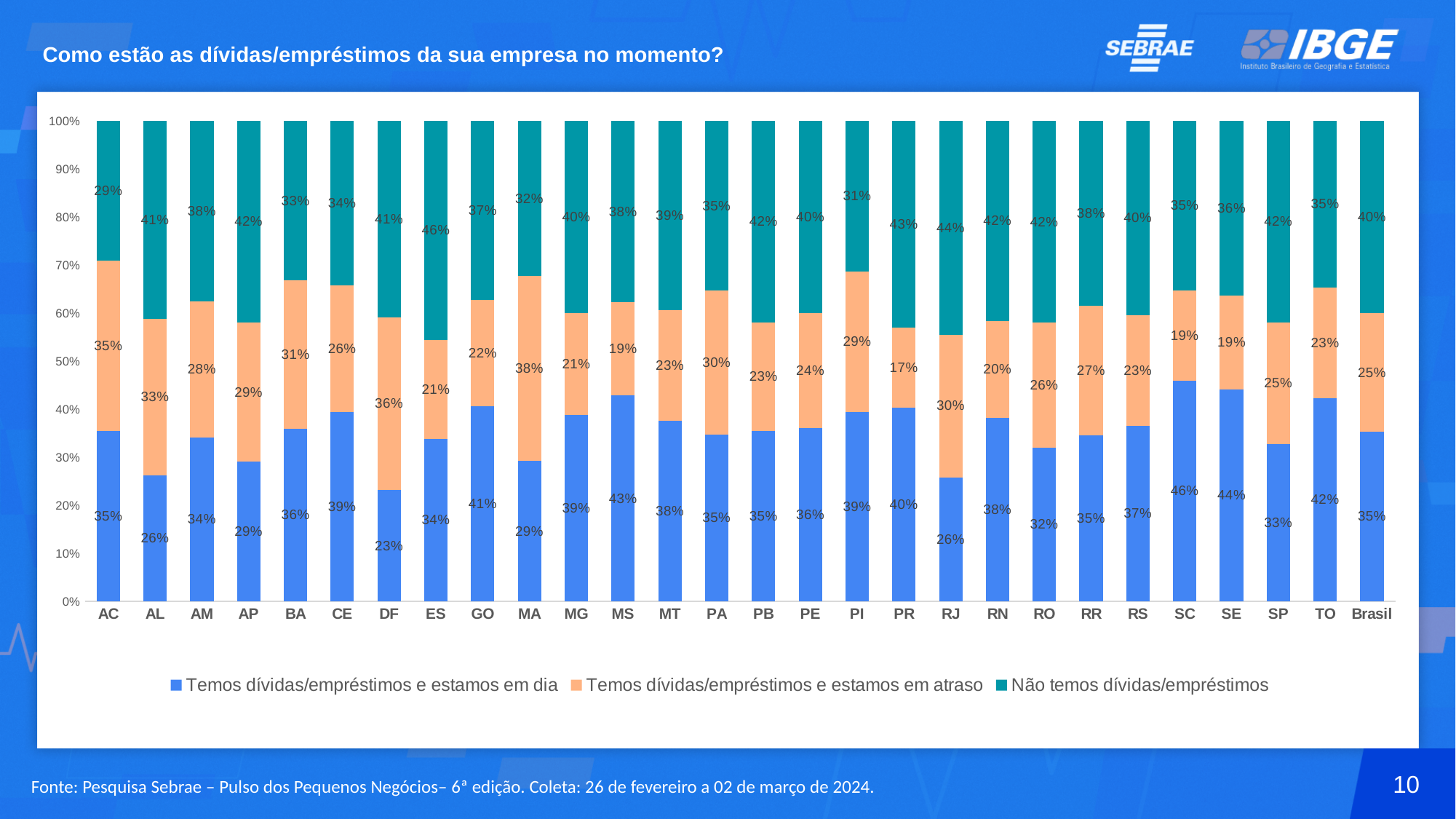
Which state has the lowest value for 'Temos dívidas/empréstimos e estamos em atraso'? PR Which state has the highest value for 'Não temos dívidas/empréstimos'? ES Which state has the lowest value for 'Temos dívidas/empréstimos e estamos em dia'? DF Which state has the highest value for 'Temos dívidas/empréstimos e estamos em dia'? SC What is the difference between the 'Temos dívidas/empréstimos e estamos em dia' values for SC and DF? 23% What kind of chart is shown on the slide? Stacked bar chart What percentage of companies in SC report 'Temos dívidas/empréstimos e estamos em dia'? 46% How many categories are shown on the x axis? 28 What is the value for MA in the 'Temos dívidas/empréstimos e estamos em atraso' series? 38% What is the value for Brasil in the 'Não temos dívidas/empréstimos' series? 40% Which is larger: the 'Temos dívidas/empréstimos e estamos em atraso' value for DF or for ES? DF How many series does the legend list? 3